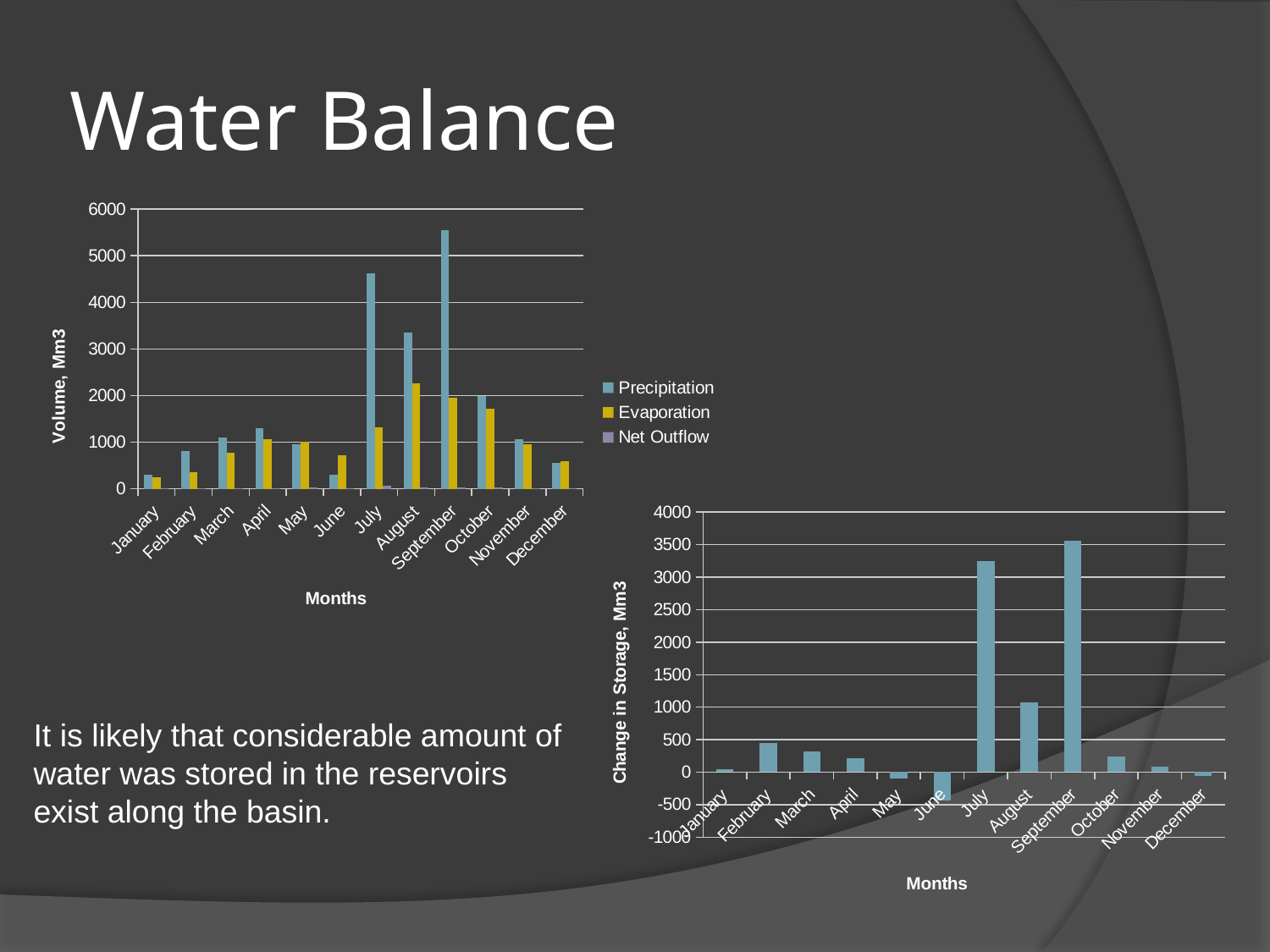
On the top-left chart (Volume, Mm3), is the Precipitation value for September greater or less than 5000? greater On the top-left chart (Volume, Mm3), how many series does the legend list? 3 What kind of chart is the bottom-right chart (Change in Storage, Mm3)? bar chart On the top-left chart (Volume, Mm3), in July, which is larger: Precipitation or Evaporation? Precipitation On the bottom-right chart (Change in Storage, Mm3), which month has the lowest value? June On the top-left chart (Volume, Mm3), how many months are shown on the x axis? 12 On the bottom-right chart (Change in Storage, Mm3), is the value for July greater or less than 3000? greater On the bottom-right chart (Change in Storage, Mm3), which is larger: the value for July or the value for August? July On the top-left chart (Volume, Mm3), is the Precipitation value for July greater or less than 4000? greater On the bottom-right chart (Change in Storage, Mm3), which month has the highest value? September On the top-left chart (Volume, Mm3), which month has the highest Precipitation? September On the top-left chart (Volume, Mm3), which month has the highest Evaporation? August